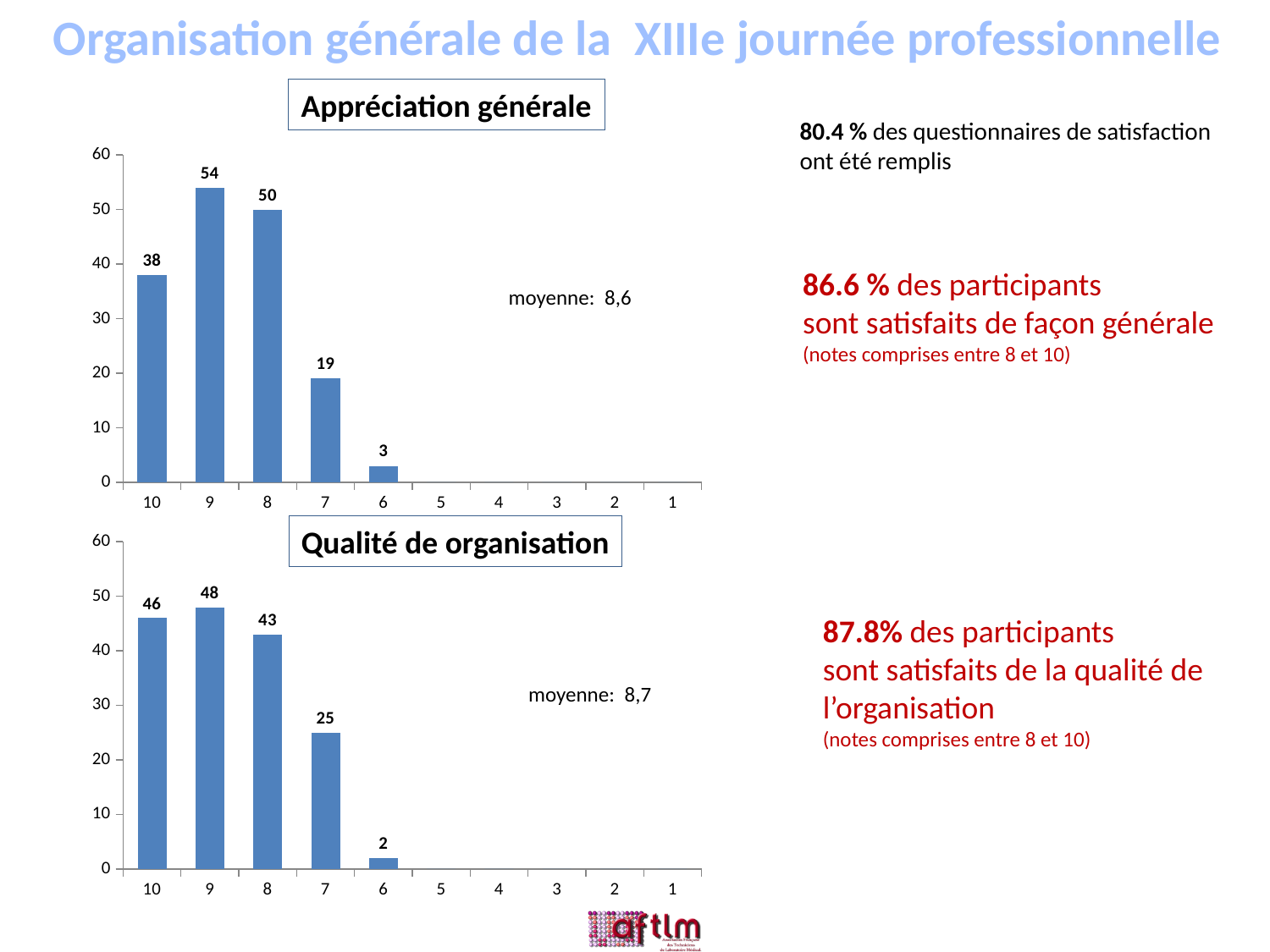
In the 'Qualité de organisation' chart, what is the difference between the values for score 9 and score 7? 23 In the 'Qualité de organisation' chart, which score has the highest value? 9 In the 'Appréciation générale' chart, what is the value for score 9? 54 In the 'Qualité de organisation' chart, what is the value for score 8? 43 In the 'Qualité de organisation' chart, what is the value for score 6? 2 How many score categories are shown on the x axis of the 'Qualité de organisation' chart? 10 In the 'Appréciation générale' chart, which is larger, the value for score 10 or the value for score 7? score 10 In the 'Appréciation générale' chart, what is the value for score 7? 19 In the 'Appréciation générale' chart, what is the difference between the values for score 10 and score 8? 12 What kind of chart is the 'Appréciation générale' chart? bar chart In the 'Appréciation générale' chart, which score has the highest value? 9 What average (moyenne) is shown on the 'Qualité de organisation' chart? 8,7